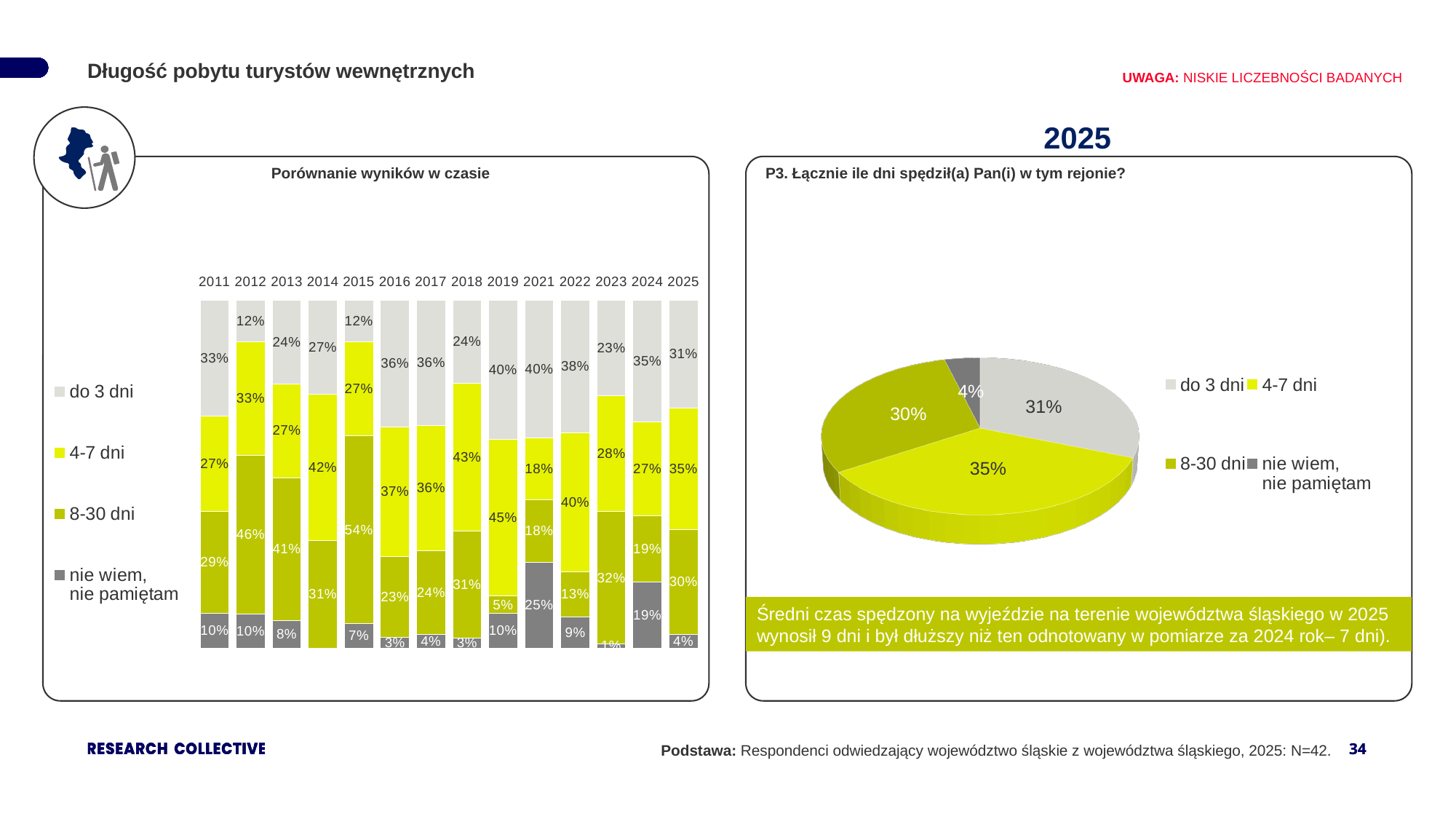
In the chart 'Porównanie wyników w czasie', what is the value for '8-30 dni' in 2015? 54% How many series does the legend of the chart 'Porównanie wyników w czasie' list? 4 In the pie chart on the right, what share does '4-7 dni' have? 35% What kind of chart is the chart on the right titled 'P3. Łącznie ile dni spędził(a) Pan(i) w tym rejonie?'? Pie chart In the chart 'Porównanie wyników w czasie', what is the value for 'do 3 dni' in 2019? 40% In the chart 'Porównanie wyników w czasie', what is the value for 'nie wiem, nie pamiętam' in 2021? 25% In the chart 'Porównanie wyników w czasie', which year has the lowest value for 'do 3 dni'? 2012 and 2015 In the chart 'Porównanie wyników w czasie', which is larger: the '4-7 dni' value in 2024 or in 2025? 2025 In the chart 'Porównanie wyników w czasie', what is the difference between the '4-7 dni' values for 2019 and 2021? 27 percentage points How many years are shown on the x axis of the chart 'Porównanie wyników w czasie'? 14 In the pie chart on the right, which category has the smallest slice? nie wiem, nie pamiętam In the chart 'Porównanie wyników w czasie', which year has the highest value for '8-30 dni'? 2015